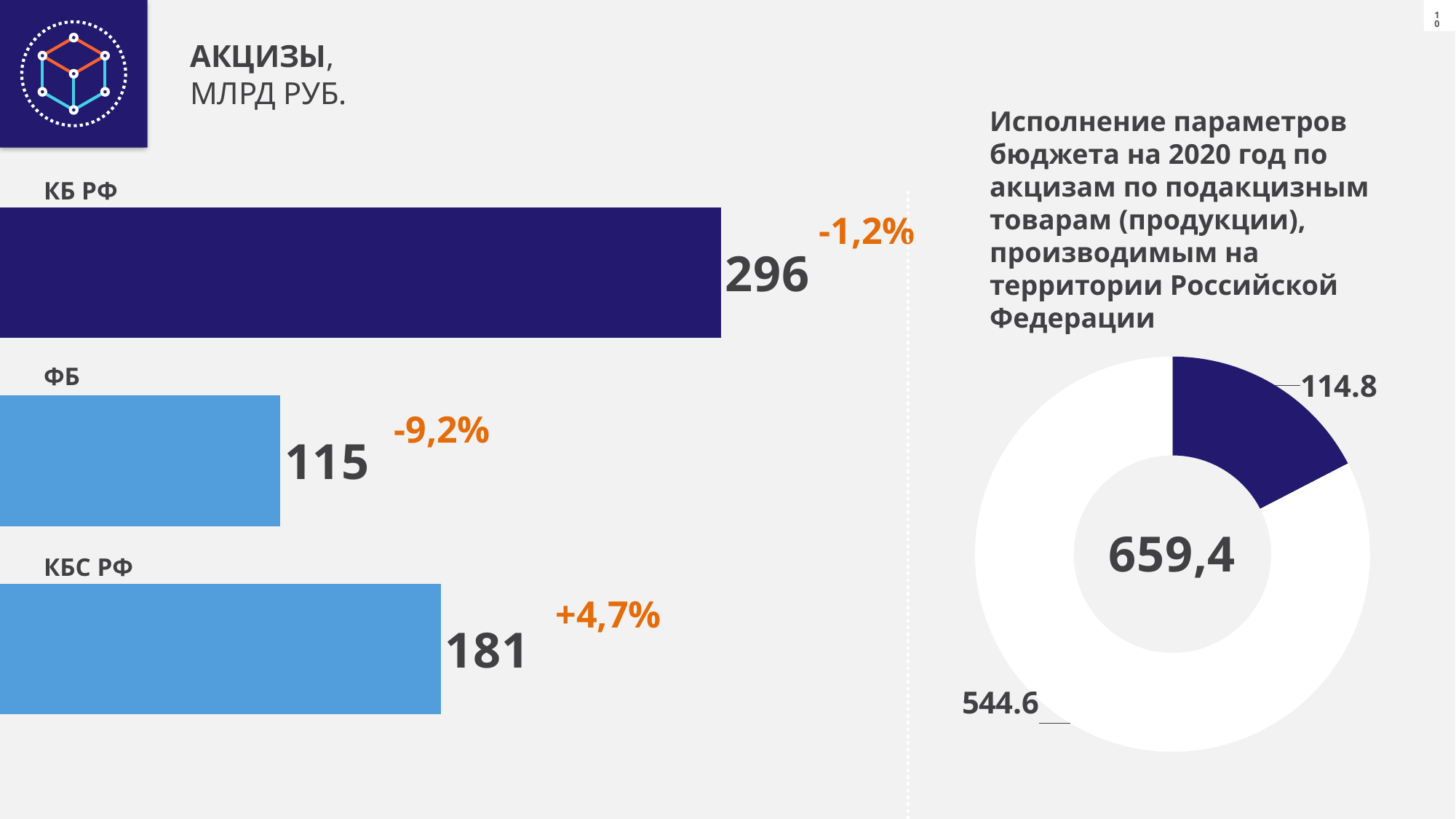
On the donut chart on the right, what number is printed in the centre? 659,4 On the bar chart on the left, what is the value for КБС РФ? 181 On the bar chart on the left, what is the value for КБ РФ? 296 On the bar chart on the left, which category has the highest value? КБ РФ On the bar chart on the left, which is larger, the value for КБС РФ or the value for ФБ? КБС РФ On the bar chart on the left, what percentage change is shown next to КБС РФ? +4,7% On the bar chart on the left, what is the difference between the values for КБ РФ and ФБ? 181 What kind of chart is shown on the left of the slide? Bar chart On the donut chart on the right, what value is shown for the dark blue segment? 114.8 On the bar chart on the left, what is the value for ФБ? 115 On the bar chart on the left, which category has the lowest value? ФБ On the bar chart on the left, how many bars are shown? 3